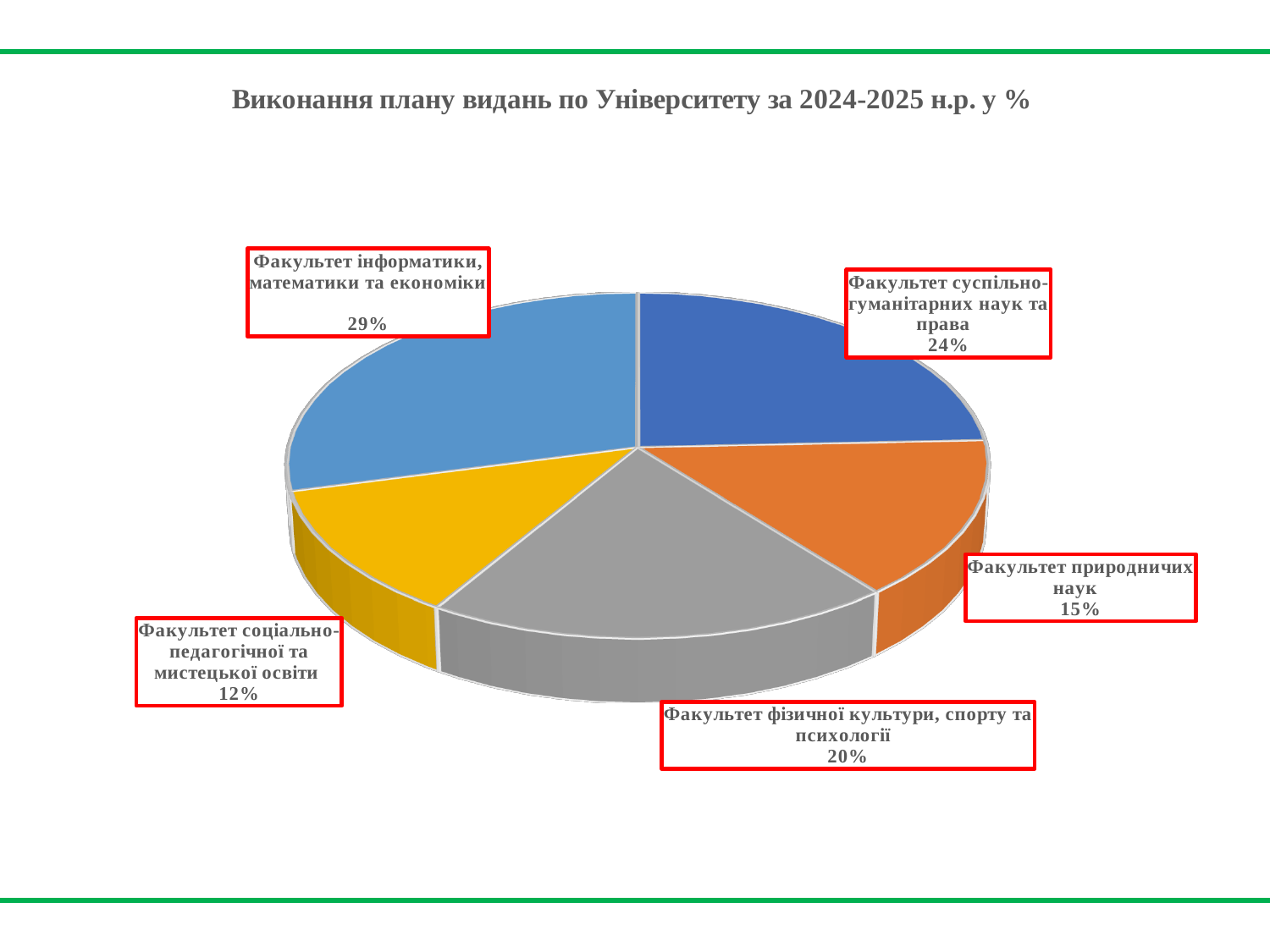
Which faculty has the smallest share of the pie? Факультет соціально-педагогічної та мистецької освіти Which has a larger share: Факультет суспільно-гуманітарних наук та права or Факультет фізичної культури, спорту та психології? Факультет суспільно-гуманітарних наук та права What kind of chart is shown on the slide? Pie chart Which faculty has the largest share of the pie? Факультет інформатики, математики та економіки What percentage is shown for Факультет соціально-педагогічної та мистецької освіти? 12% What percentage is shown for Факультет суспільно-гуманітарних наук та права? 24% How many slices does the pie chart have? 5 What percentage is shown for Факультет інформатики, математики та економіки? 29% What is the difference between the shares of Факультет інформатики, математики та економіки and Факультет природничих наук? 14% What percentage is shown for Факультет фізичної культури, спорту та психології? 20% What is the title of the chart? Виконання плану видань по Університету за 2024-2025 н.р. у % What percentage is shown for Факультет природничих наук? 15%